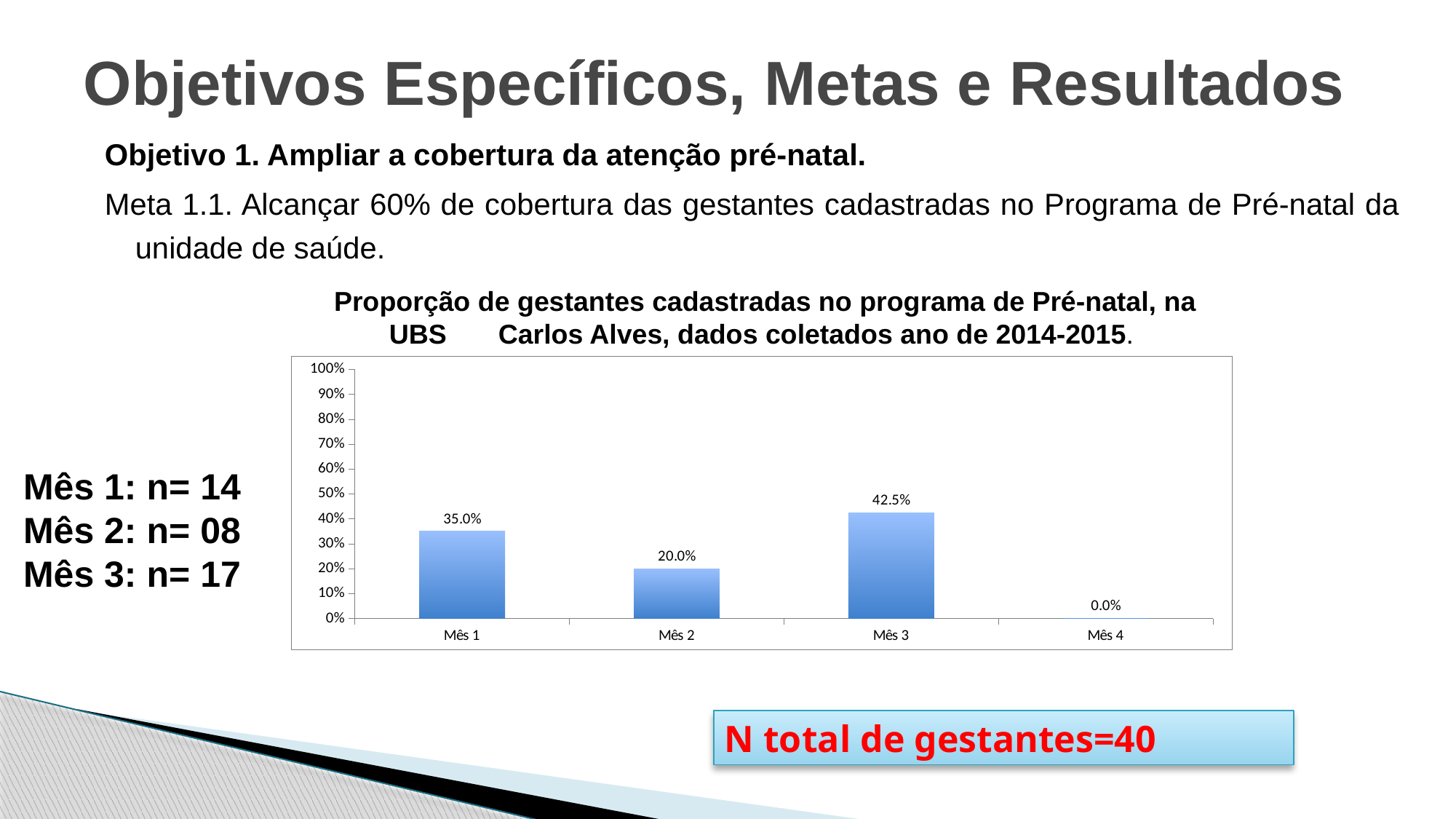
Which is larger, the value for Mês 1 or the value for Mês 2? Mês 1 What is the maximum value shown on the y axis? 100% How many months are shown on the x axis? 4 Which month has the highest value? Mês 3 Which month has the lowest value? Mês 4 Is the value for Mês 3 greater or less than 50%? less What kind of chart is shown on the slide? bar chart What is the value for Mês 4? 0.0% What is the difference between the values for Mês 3 and Mês 1? 7.5% What is the value for Mês 2? 20.0% What is the value for Mês 1? 35.0% What is the value for Mês 3? 42.5%